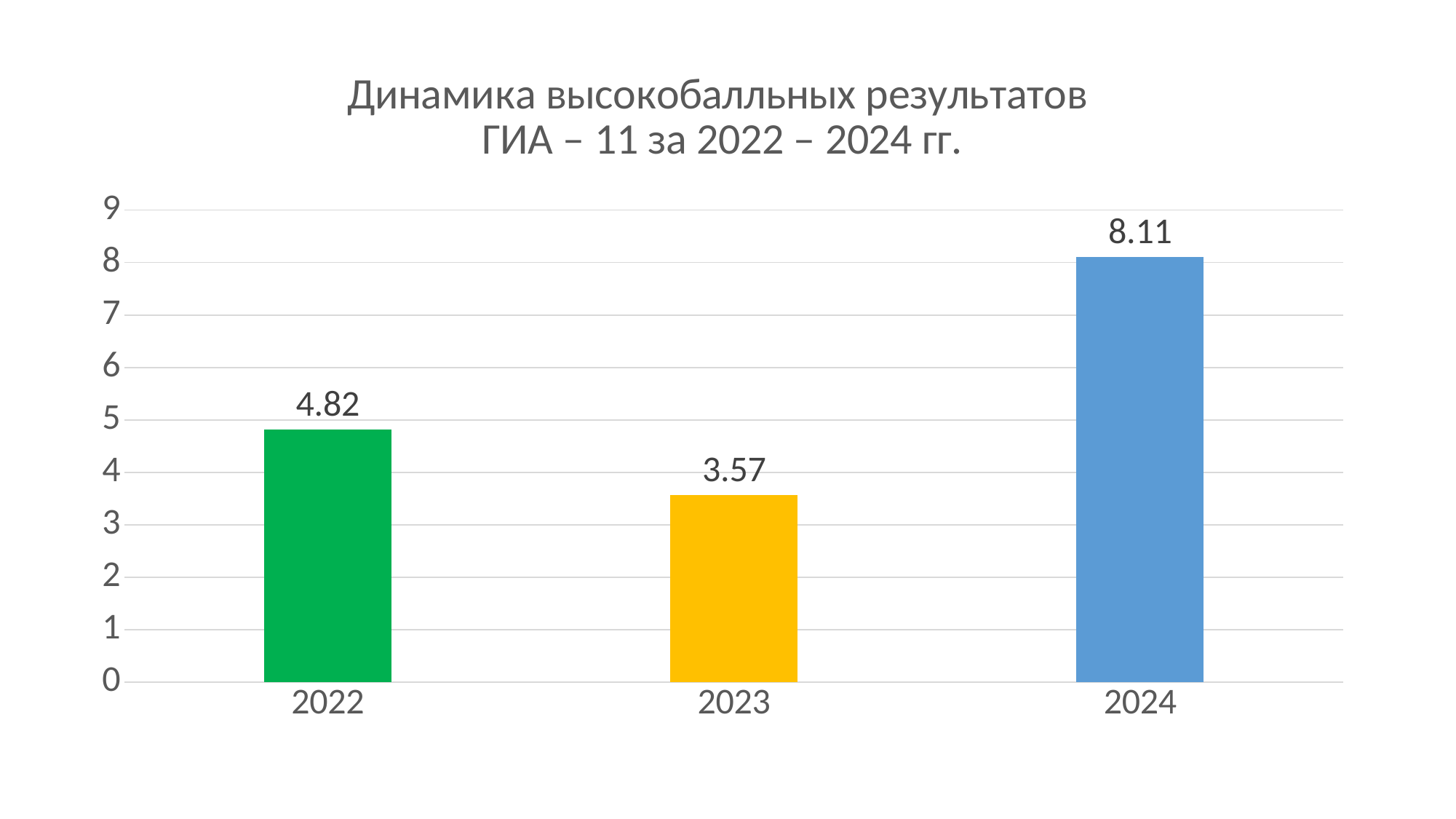
What is the difference between the values for 2024 and 2022? 3.29 Which year has the lowest value? 2023 Is the value for 2024 greater or less than 7? greater What is the value for 2024? 8.11 What is the difference between the values for 2022 and 2023? 1.25 What is the value for 2023? 3.57 Which is larger, the value for 2022 or the value for 2023? 2022 What is the value for 2022? 4.82 What kind of chart is shown on the slide? bar chart How many years are shown on the chart? 3 What colour is the bar for 2024? blue Which year has the highest value? 2024